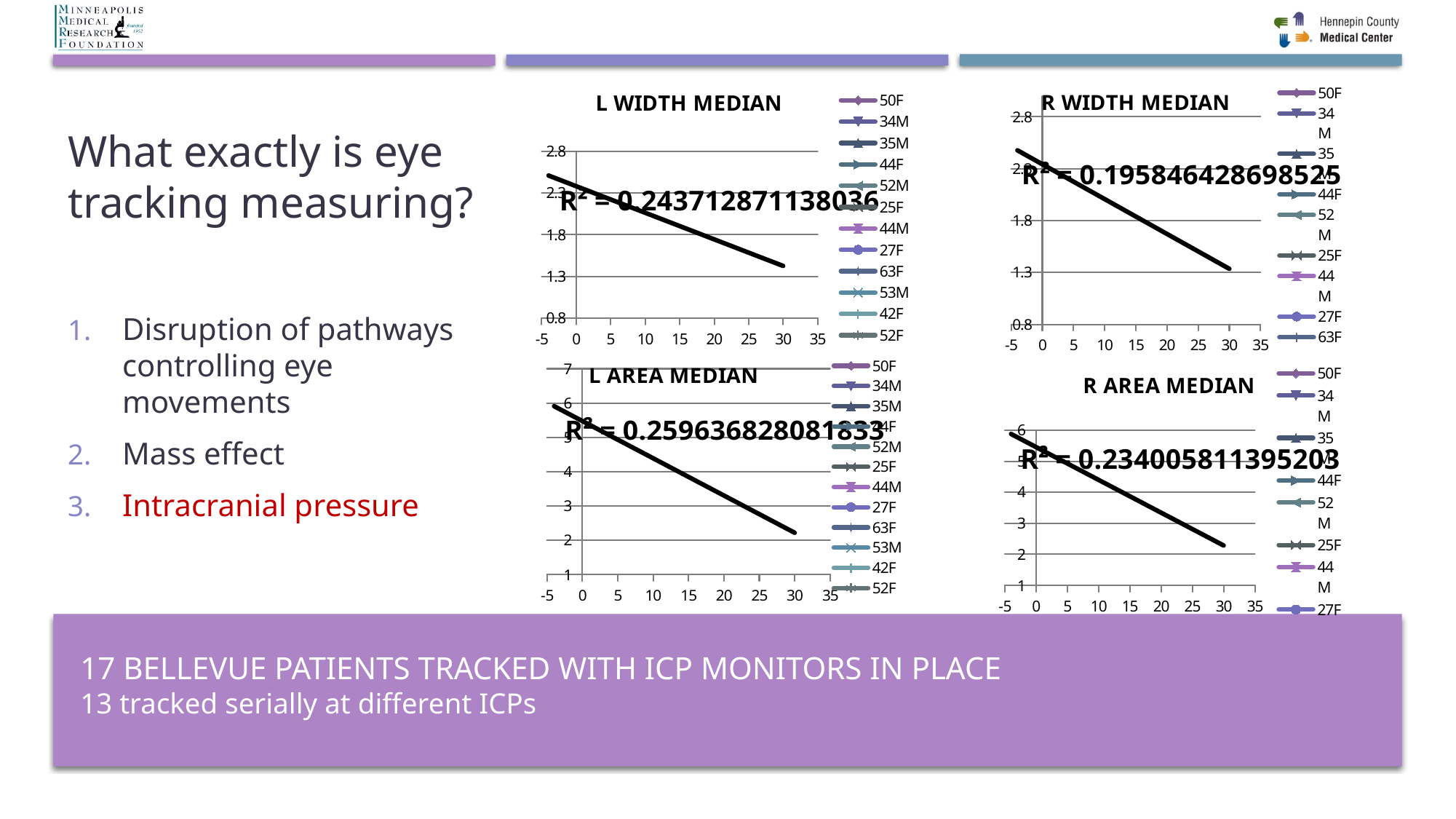
What is the highest value shown on the y-axis of the L AREA MEDIAN chart? 7 In the L AREA MEDIAN chart, what R² value is displayed? R² = 0.259636828081833 In the L WIDTH MEDIAN chart, what R² value is displayed? R² = 0.243712871138036 What is the title of the chart in the top-right position of the slide? R WIDTH MEDIAN In the L WIDTH MEDIAN chart, does the trend line rise or fall as the x-axis value increases? Fall How many series does the legend of the L WIDTH MEDIAN chart list? 12 In the R AREA MEDIAN chart, what R² value is displayed? R² = 0.234005811395203 Which of the four charts shows the lowest R² value? R WIDTH MEDIAN Which chart has the larger R² value, L WIDTH MEDIAN or R WIDTH MEDIAN? L WIDTH MEDIAN In the R WIDTH MEDIAN chart, what R² value is displayed? R² = 0.195846428698525 Which of the four charts shows the highest R² value? L AREA MEDIAN In the R AREA MEDIAN chart, does the trend line rise or fall from left to right? Fall